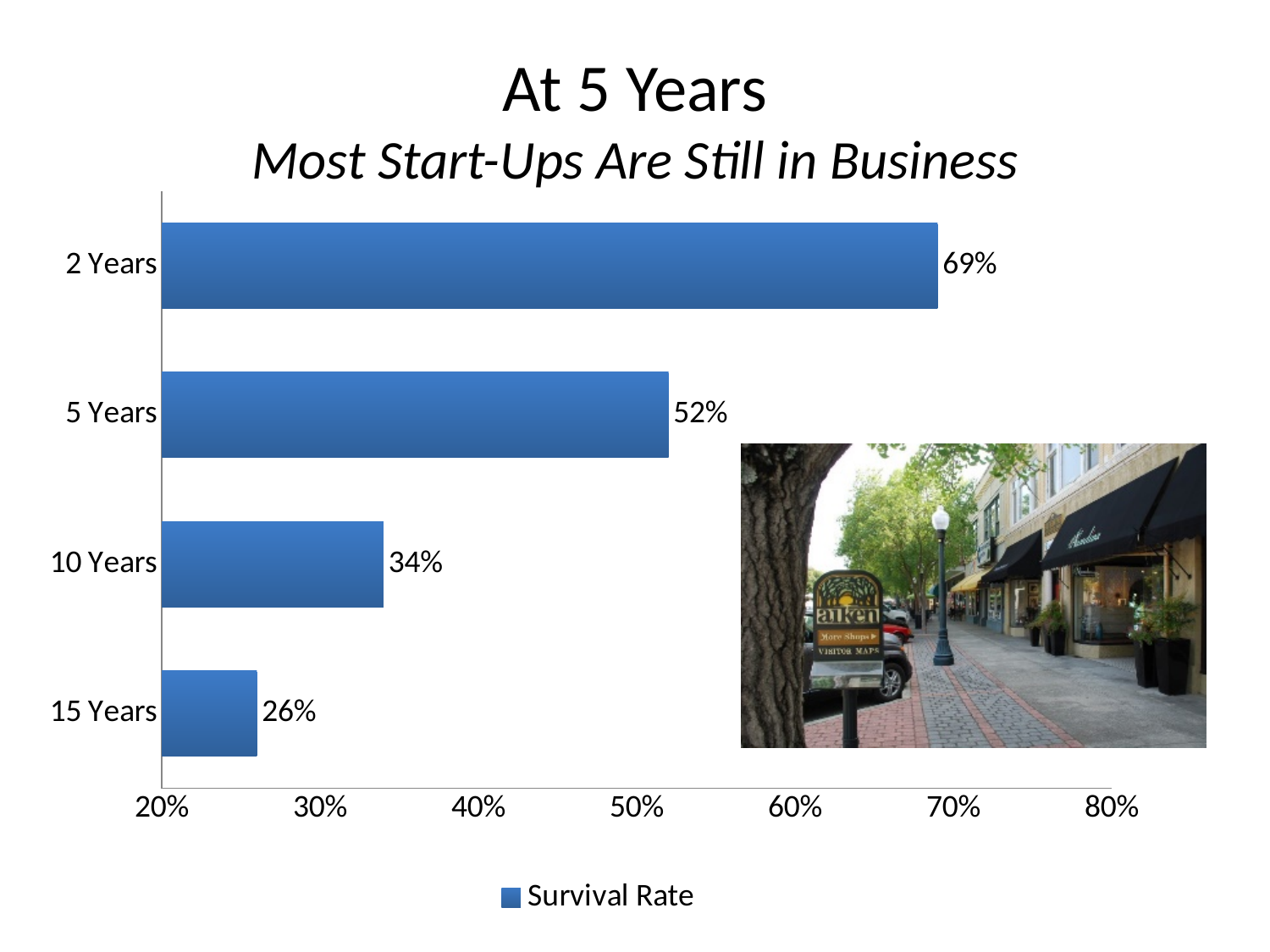
Is the survival rate at 5 Years greater or less than 50%? greater Which is larger, the survival rate at 10 Years or at 15 Years? 10 Years What is the survival rate at 5 Years? 52% How many series does the legend list? 1 What is the survival rate at 10 Years? 34% What is the survival rate at 2 Years? 69% What is the difference between the survival rate at 2 Years and at 5 Years? 17% Which category has the lowest survival rate? 15 Years What kind of chart is shown on the slide? bar chart Which category has the highest survival rate? 2 Years How many categories are shown in the chart? 4 What is the survival rate at 15 Years? 26%